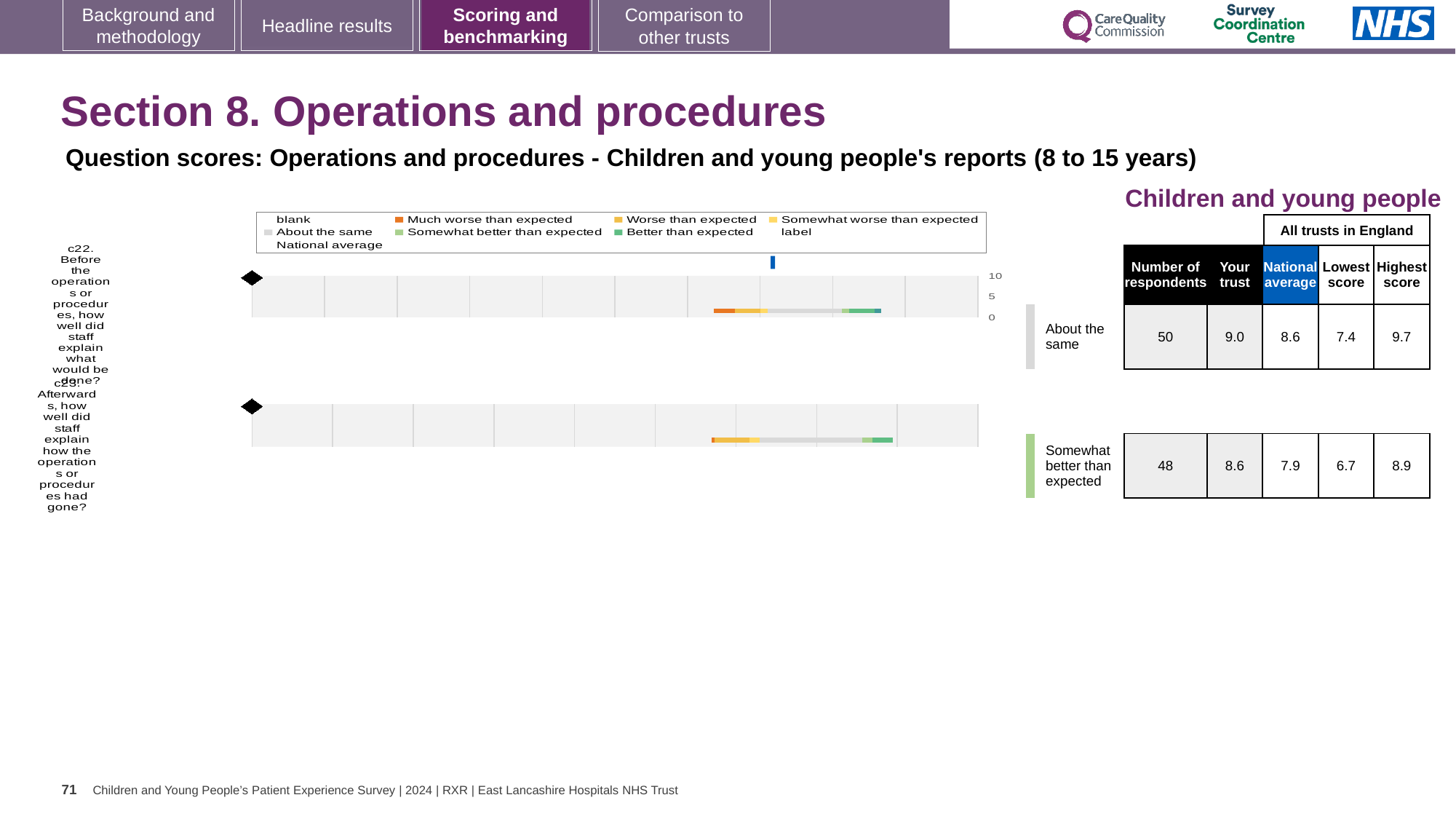
Which benchmarking category is question c23 placed in? Somewhat better than expected What is the highest score across all trusts in England for question c23? 8.9 What kind of chart is used to show the question scores for c22 and c23? Bar chart By how much does the trust's score for c23 exceed the national average for c23? 0.7 Which question has the higher national average score, c22 or c23? c22 How many respondents answered question c22? 50 What is the national average score for question c23 (Afterwards, how well did staff explain how the operations or procedures had gone?)? 7.9 What is the difference between the highest score and the lowest score for question c22? 2.3 What colour does the legend use for 'Much worse than expected'? Orange What is the 'Your trust' score for question c22 (Before the operations or procedures, how well did staff explain what would be done?)? 9.0 How many survey questions are plotted in the chart? 2 Which question has the higher 'Your trust' score, c22 or c23? c22